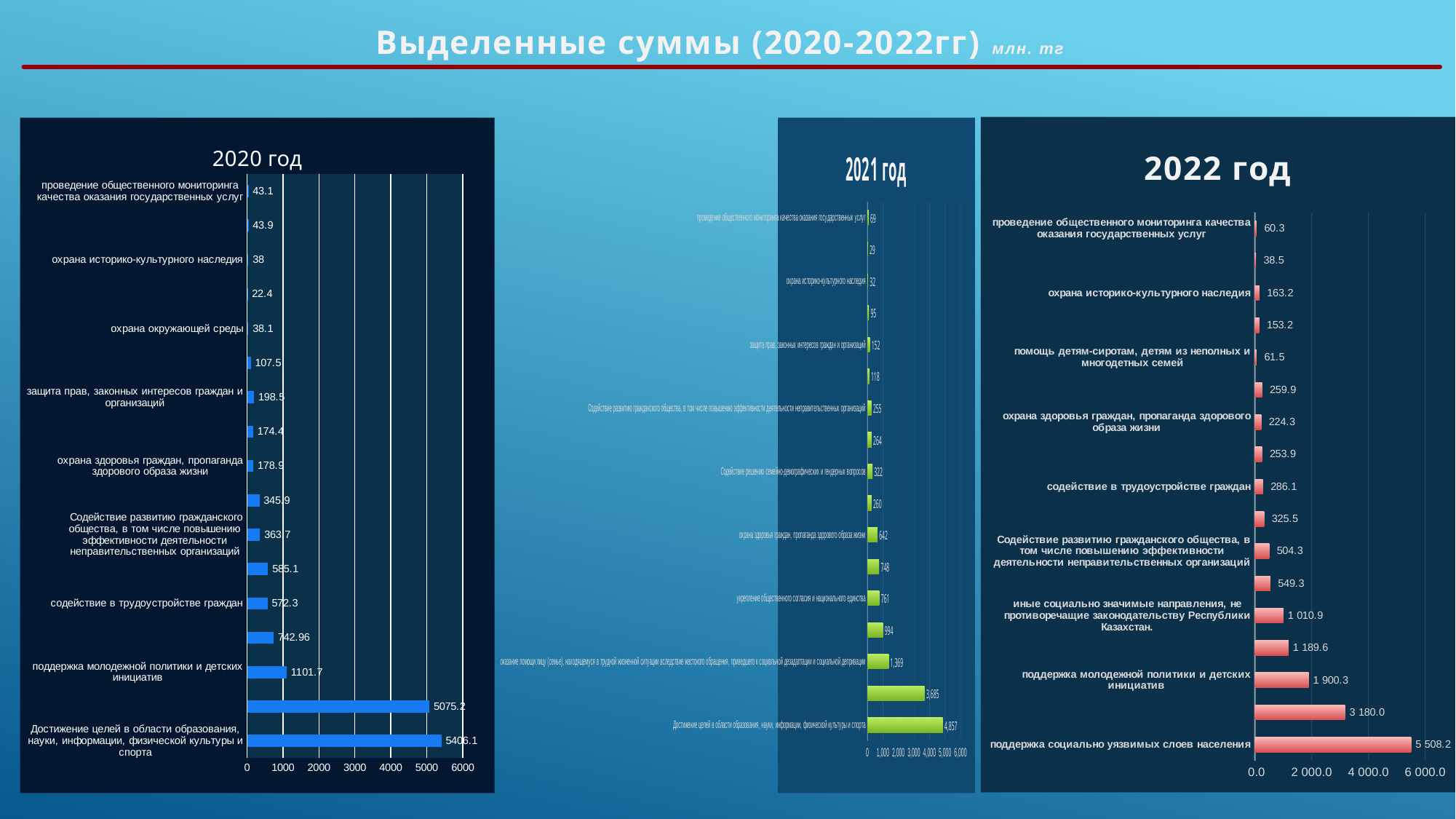
What type of chart is the 2022 год chart? Horizontal bar chart On the 2020 год chart, what is the smallest value shown? 22.4 On the 2020 год chart, how many bars are plotted? 17 On the 2022 год chart, which is larger: охрана историко-культурного наследия or помощь детям-сиротам, детям из неполных и многодетных семей? охрана историко-культурного наследия On the 2022 год chart, what is the value for поддержка молодежной политики и детских инициатив? 1 900.3 On the 2020 год chart, what is the value for содействие в трудоустройстве граждан? 572.3 On the 2020 год chart, which category has the highest value? Достижение целей в области образования, науки, информации, физической культуры и спорта On the 2021 год chart, what is the smallest value shown? 29 On the 2021 год chart, what is the largest value shown? 4,857 How many charts are shown on the slide? 3 On the 2020 год chart, what is the difference between the two largest values, 5406.1 and 5075.2? 330.9 On the 2022 год chart, which category has the highest value? поддержка социально уязвимых слоев населения